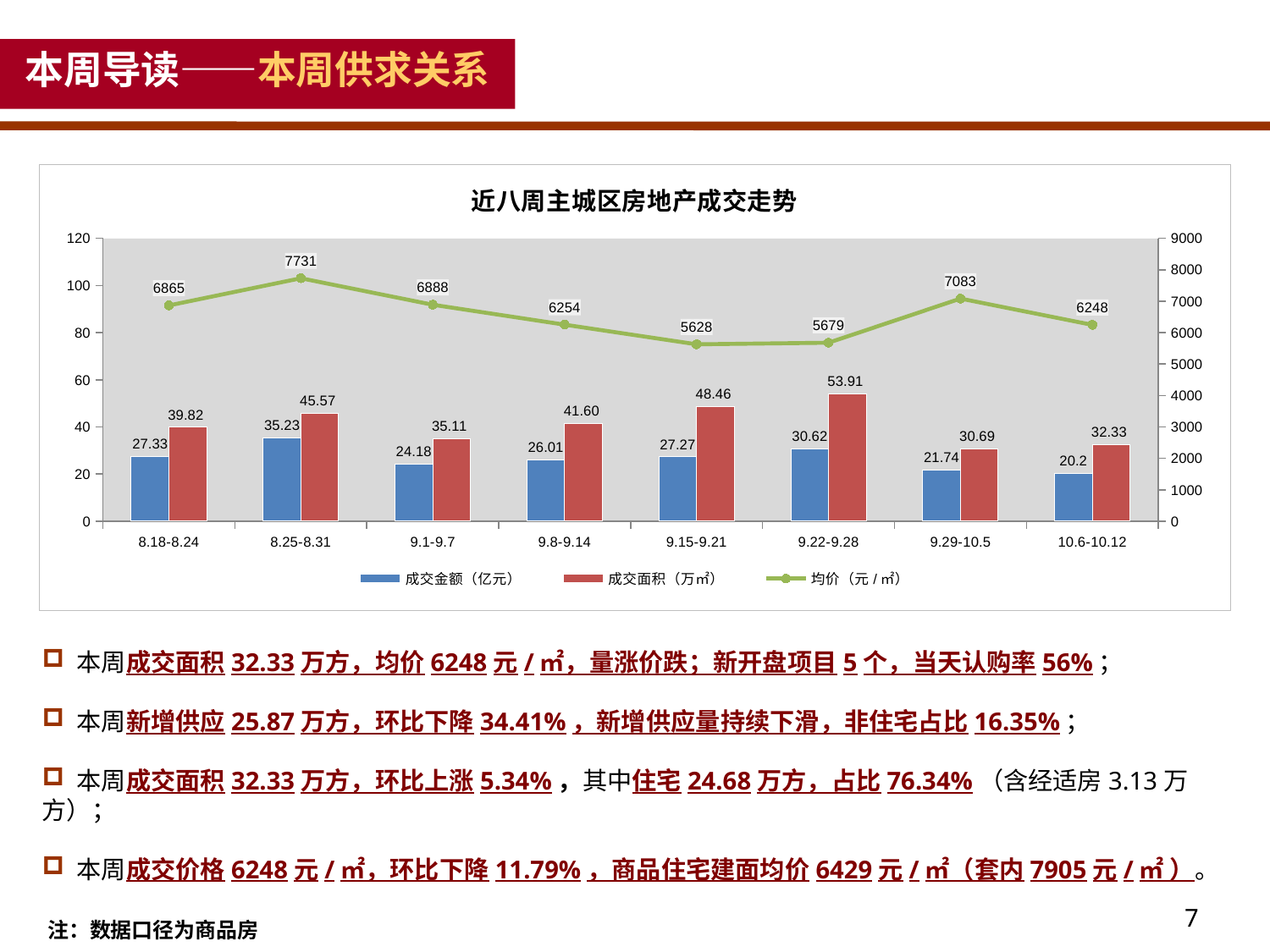
What kind of chart is this? Combined bar and line chart Which week has the highest 均价（元/㎡）? 8.25-8.31 Which week has the lowest 成交面积（万㎡）? 9.29-10.5 What is the difference between the 成交面积（万㎡） values for 9.22-9.28 and 9.29-10.5? 23.22 How many weeks are shown on the x axis? 8 Which is larger, the 成交金额（亿元） for 8.25-8.31 or for 9.22-9.28? 8.25-8.31 What is the 成交面积（万㎡） value for 9.22-9.28? 53.91 Which week has the lowest 均价（元/㎡）? 9.15-9.21 What is the 成交金额（亿元） value for 10.6-10.12? 20.2 What is the title of the chart? 近八周主城区房地产成交走势 What is the 均价（元/㎡） value for 8.25-8.31? 7731 How many series does the legend list? 3